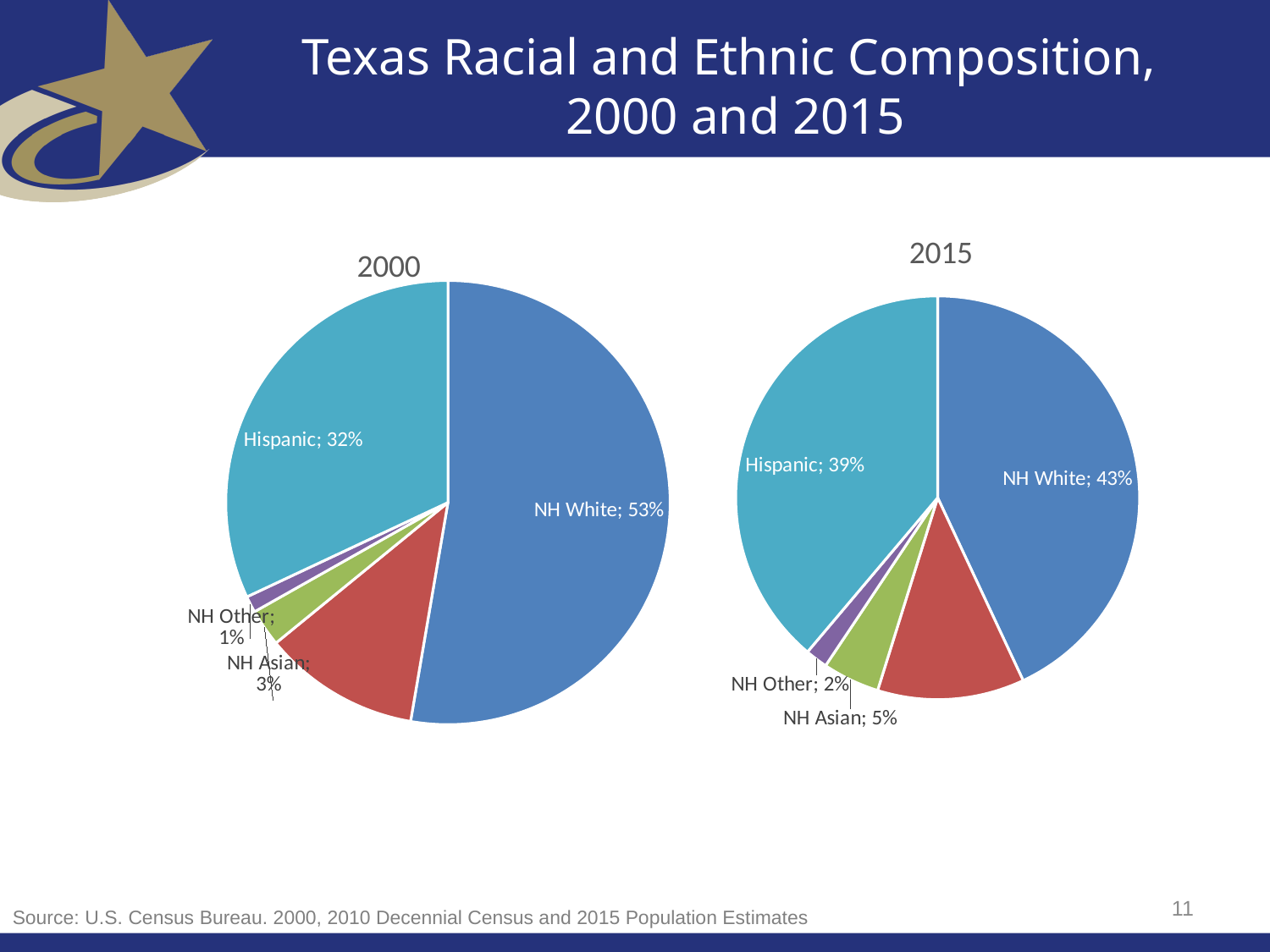
In the 2015 pie chart, what share is labelled for NH Other? 2% In the 2015 pie chart, what share is labelled for Hispanic? 39% In the 2000 pie chart, what share is labelled for NH Asian? 3% By how many percentage points did the NH White share fall from the 2000 pie chart to the 2015 pie chart? 10 percentage points What kind of chart is used for the 2015 data? Pie chart How many slices does the 2000 pie chart have? 5 In the 2015 pie chart, which labelled group has the largest share? NH White In the 2015 pie chart, what is the combined share of NH Asian and NH Other? 7% In the 2000 pie chart, which labelled group has the smallest share? NH Other What is the title of the slide containing the two pie charts? Texas Racial and Ethnic Composition, 2000 and 2015 In the 2015 pie chart, which is larger, the Hispanic share or the NH White share? NH White In the 2000 pie chart, what share is labelled for NH White? 53%